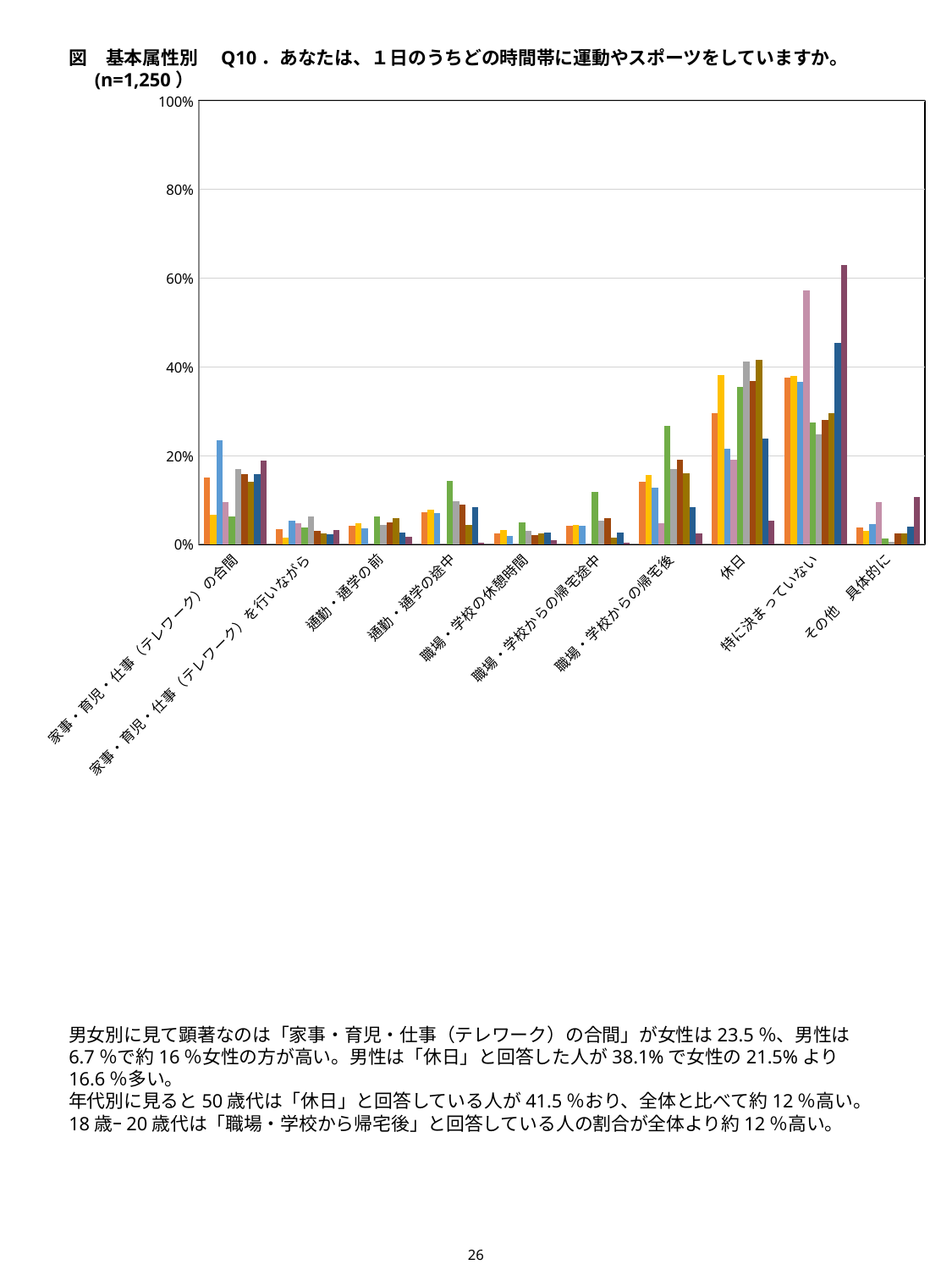
Is the tallest bar in the 特に決まっていない category greater or less than 40%? greater Are all the bars in the 通勤・通学の前 category greater or less than 20%? less Which category contains the tallest bar in the chart? 特に決まっていない What kind of chart is shown on the slide? bar chart What is the maximum value shown on the y axis of the chart? 100% Which category has a taller tallest bar: 休日 or 通勤・通学の前? 休日 Is the tallest bar in the 休日 category greater or less than 20%? greater What is the sample size (n) stated in the chart title? n=1,250 How many categories are shown along the x axis of the chart? 10